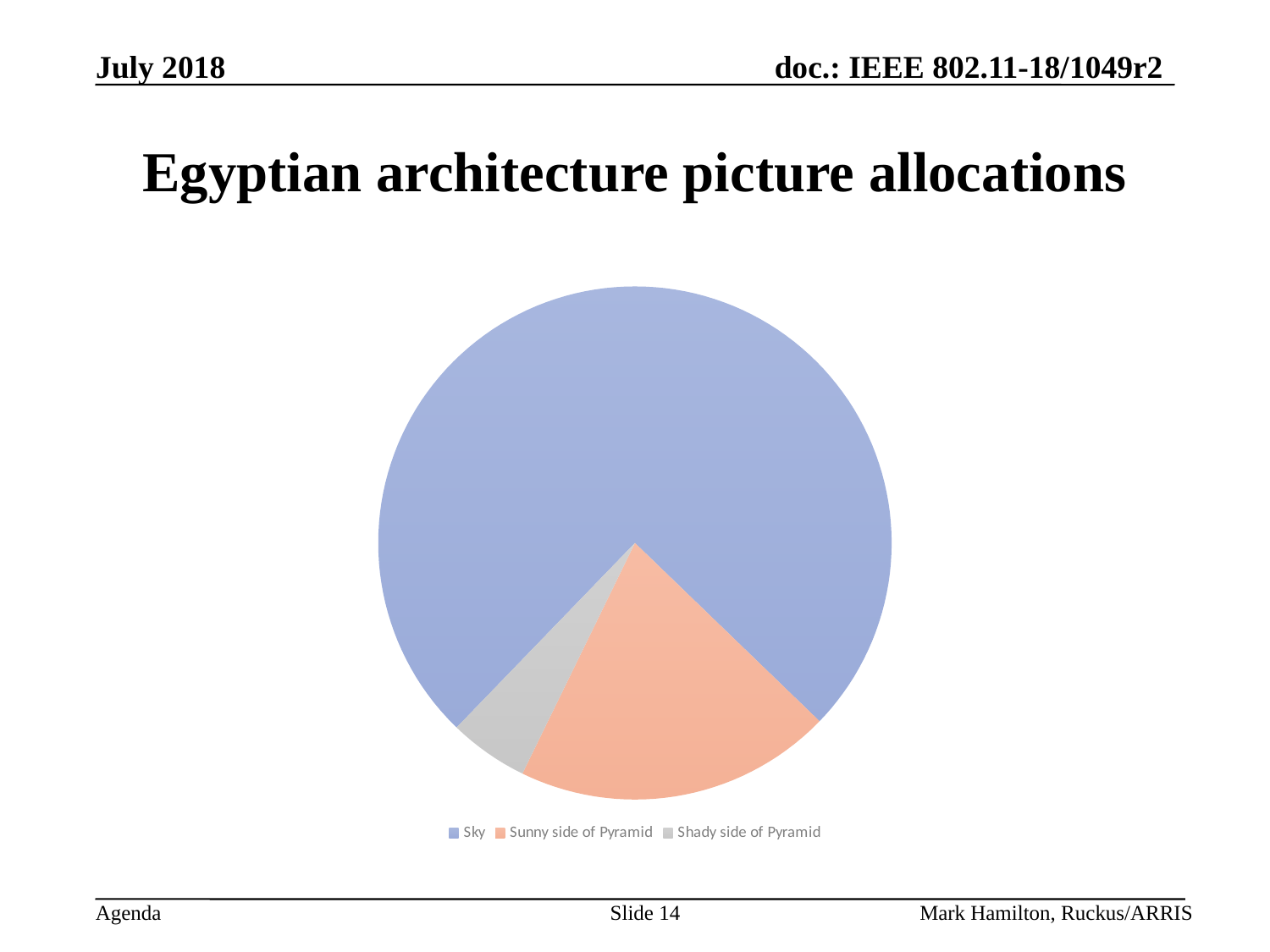
Which slice is larger, Sunny side of Pyramid or Shady side of Pyramid? Sunny side of Pyramid Which slice is larger, Sky or Sunny side of Pyramid? Sky What colour is the Sky slice in the pie chart? blue How many entries does the legend of the pie chart list? 3 Does the Sky slice take up more or less than half of the pie chart? more Which category has the largest slice of the pie chart? Sky What is the title of the chart on the slide? Egyptian architecture picture allocations Which category has the smallest slice of the pie chart? Shady side of Pyramid What kind of chart is shown on the slide? pie chart How many slices does the pie chart have? 3